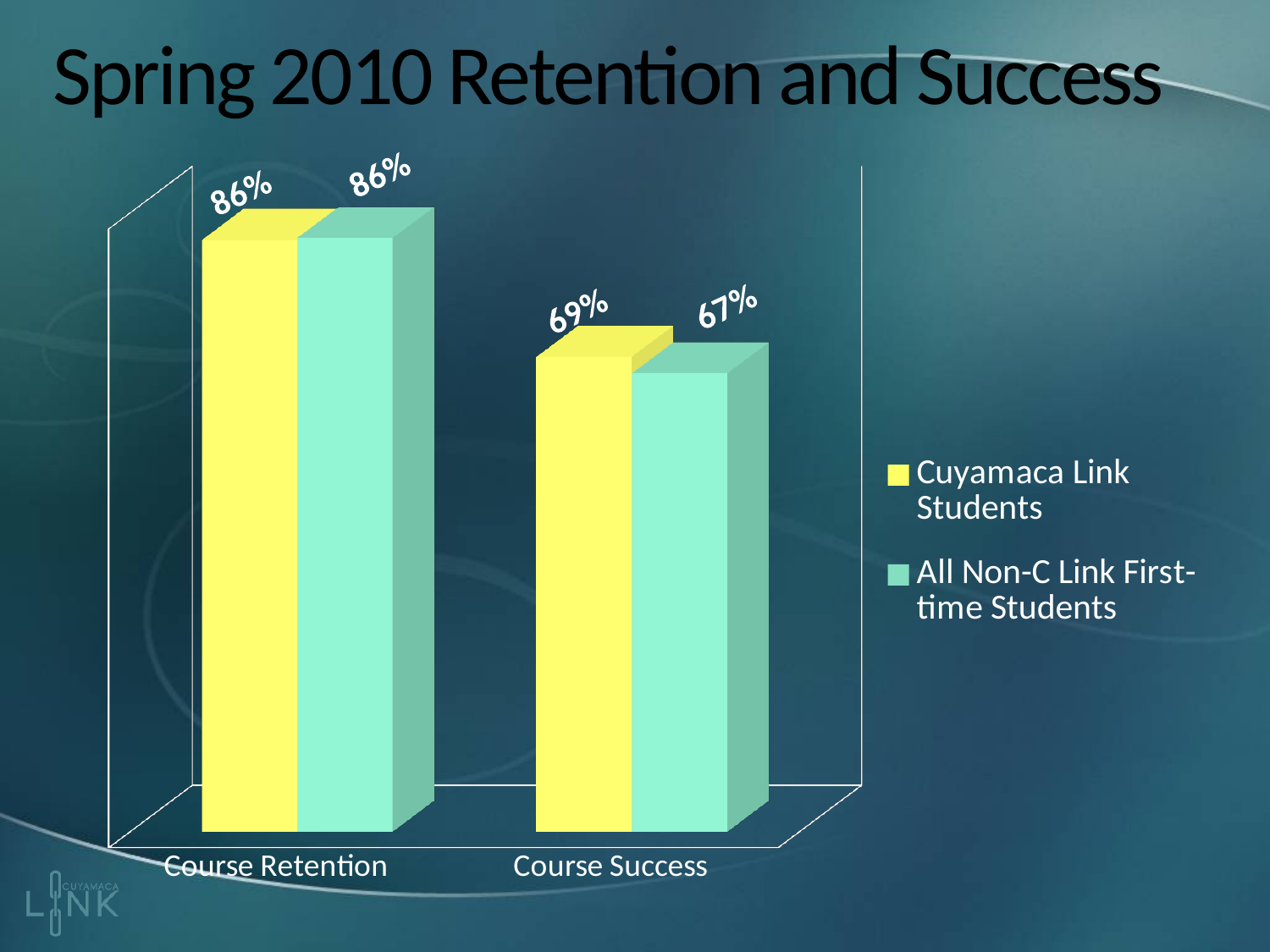
What is the Course Retention value for Cuyamaca Link Students? 86% What is the difference between the Course Success values for Cuyamaca Link Students and All Non-C Link First-time Students? 2% How many categories are shown on the x axis? 2 Which series has the higher Course Success value? Cuyamaca Link Students What is the Course Retention value for All Non-C Link First-time Students? 86% What kind of chart is shown on the slide? Bar chart What colour represents Cuyamaca Link Students in the chart? Yellow What is the Course Success value for All Non-C Link First-time Students? 67% For Cuyamaca Link Students, what is the difference between Course Retention and Course Success? 17% How many series does the legend list? 2 Which category has the higher value for Cuyamaca Link Students, Course Retention or Course Success? Course Retention What is the Course Success value for Cuyamaca Link Students? 69%